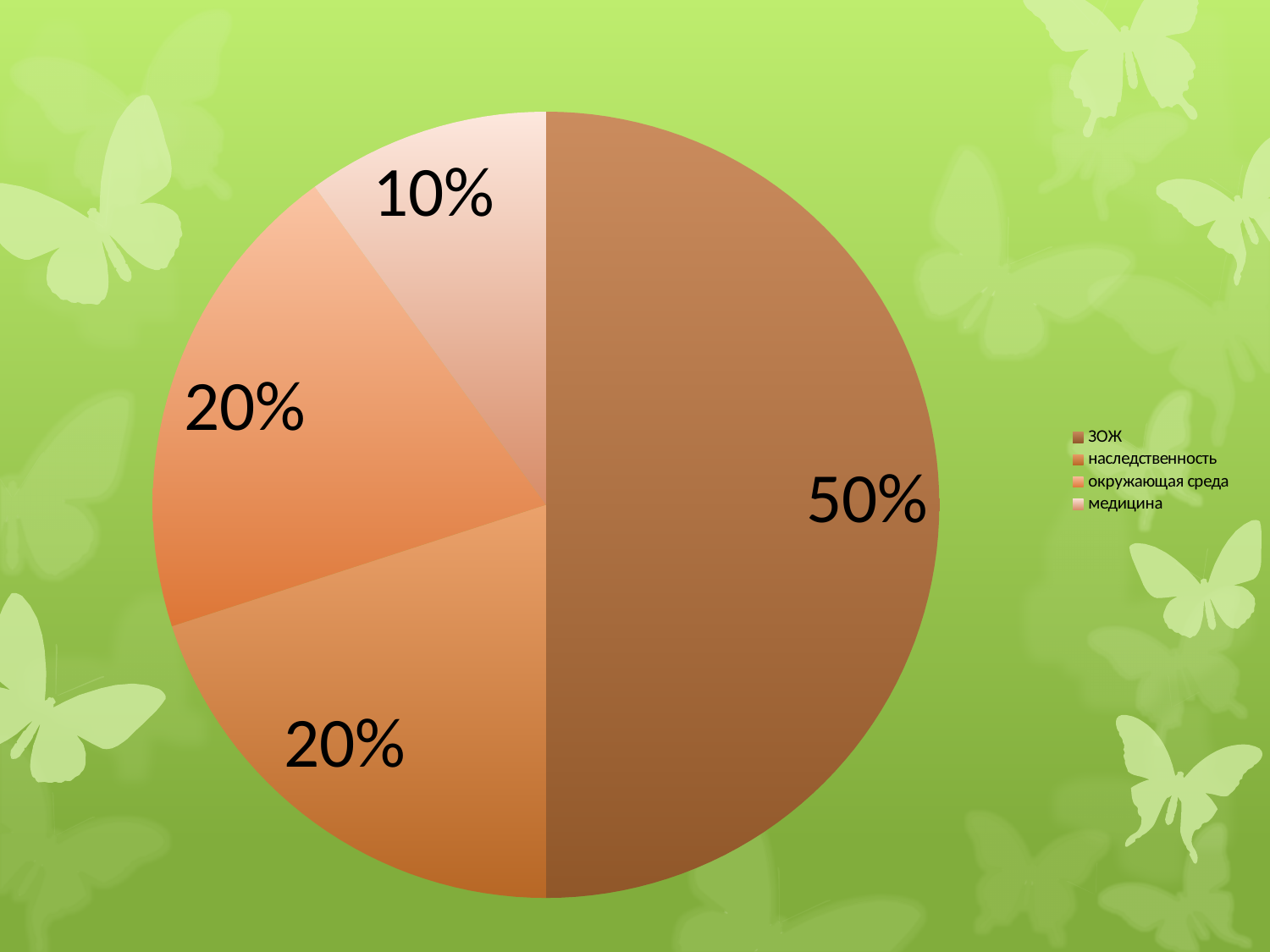
What is the difference in percentage points between ЗОЖ and медицина? 40 What kind of chart is shown on the slide? pie chart Which category has the smallest slice of the pie? медицина What share of the pie does медицина have? 10% How many slices does the pie chart have? 4 Which legend entry is listed first? ЗОЖ How many entries does the legend list? 4 What share of the pie does ЗОЖ have? 50% Which category has the largest slice of the pie? ЗОЖ What share of the pie does окружающая среда have? 20% Which is larger, the slice for ЗОЖ or the slice for наследственность? ЗОЖ What share of the pie does наследственность have? 20%